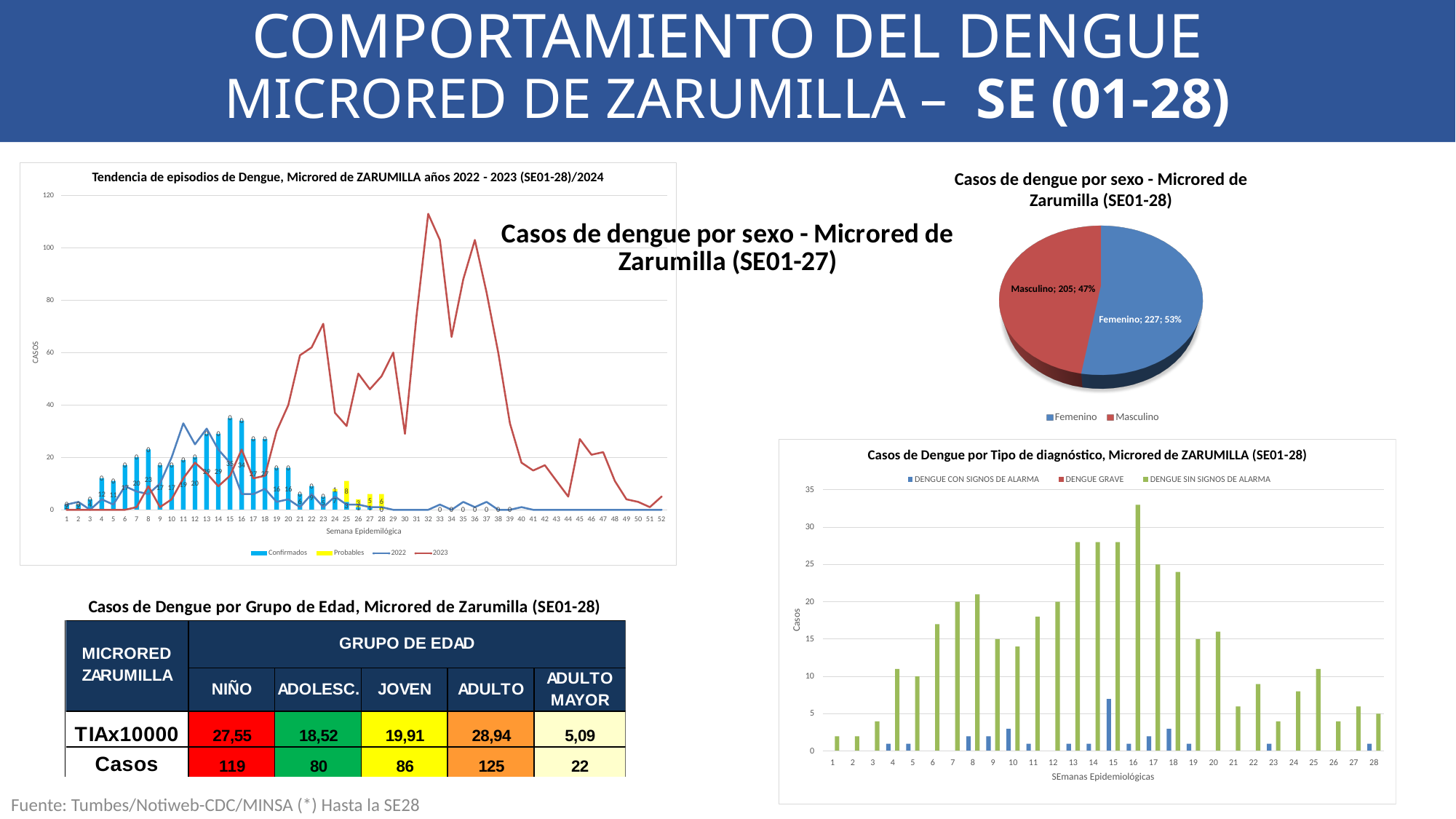
In the pie chart 'Casos de dengue por sexo', what is the total number of cases across both slices? 432 In the chart 'Casos de Dengue por Tipo de diagnóstico', which epidemiological week has the highest bar for DENGUE SIN SIGNOS DE ALARMA? 16 In the pie chart 'Casos de dengue por sexo', which sex has the larger number of cases? Femenino How many entries does the legend of the chart 'Tendencia de episodios de Dengue, Microred de ZARUMILLA años 2022 - 2023 (SE01-28)/2024' list? 4 In the pie chart 'Casos de dengue por sexo - Microred de Zarumilla (SE01-28)', how many cases are Femenino? 227 In the pie chart 'Casos de dengue por sexo', what is the difference between the Femenino and Masculino case counts? 22 In the pie chart 'Casos de dengue por sexo - Microred de Zarumilla (SE01-28)', what share of cases is Masculino? 47% What kind of chart is 'Casos de dengue por sexo - Microred de Zarumilla (SE01-28)'? Pie chart How many epidemiological weeks are shown on the x axis of the chart 'Casos de Dengue por Tipo de diagnóstico, Microred de ZARUMILLA (SE01-28)'? 28 How many entries does the legend of the pie chart 'Casos de dengue por sexo' list? 2 In the chart 'Casos de Dengue por Tipo de diagnóstico', is the DENGUE SIN SIGNOS DE ALARMA value for week 16 greater or less than 30? greater How many series does the legend of the chart 'Casos de Dengue por Tipo de diagnóstico, Microred de ZARUMILLA (SE01-28)' list? 3